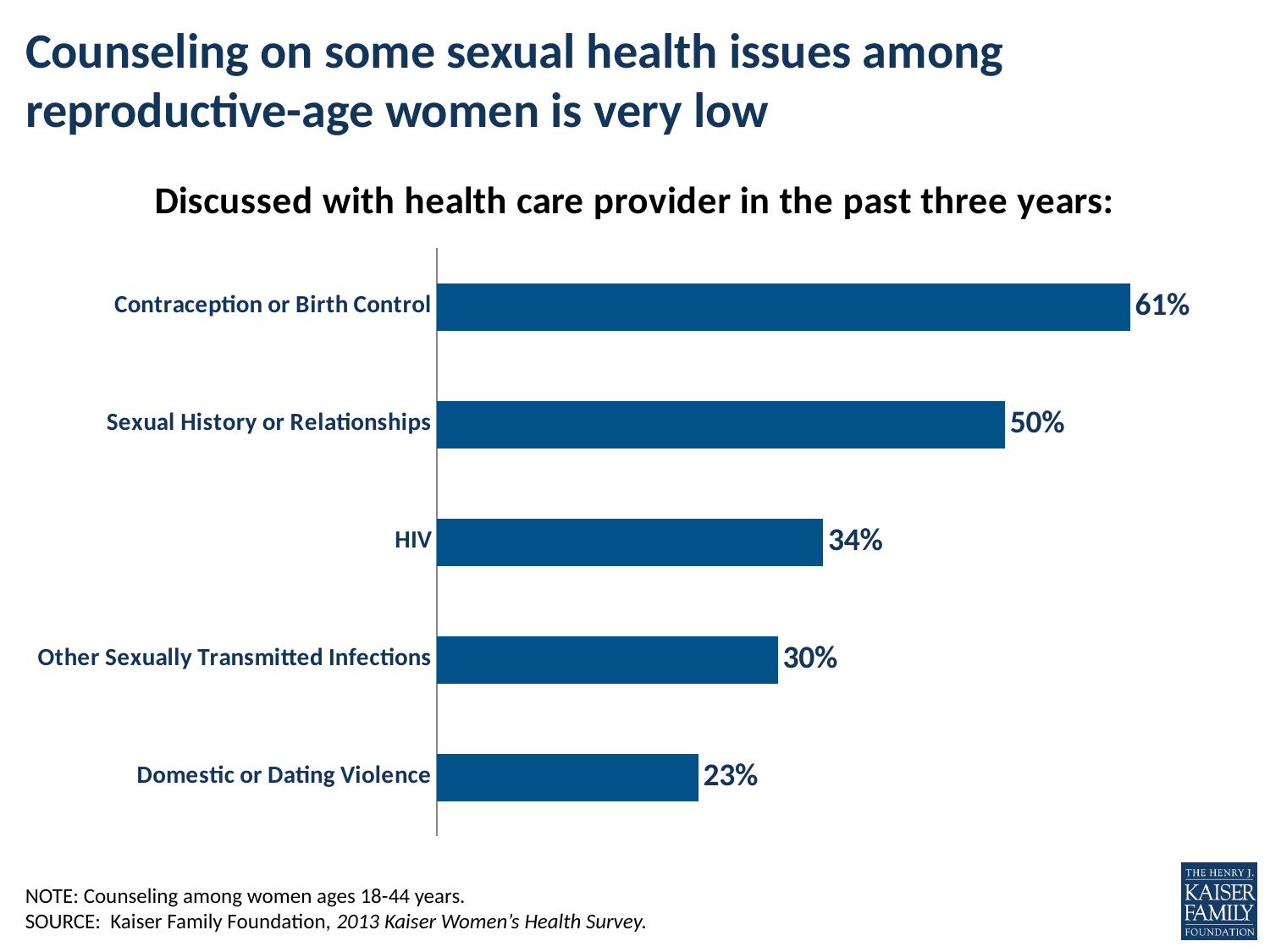
Which is larger, the value for Sexual History or Relationships or the value for HIV? Sexual History or Relationships What is the subtitle shown above the chart? Discussed with health care provider in the past three years: What percentage of women discussed Contraception or Birth Control with a health care provider in the past three years? 61% What kind of chart is shown on the slide? Bar chart What is the difference in percentage points between HIV and Other Sexually Transmitted Infections? 4 Which topic has the highest percentage of women who discussed it with a health care provider? Contraception or Birth Control What is the value shown for Other Sexually Transmitted Infections? 30% What is the difference in percentage points between Contraception or Birth Control and Sexual History or Relationships? 11 How many topics are shown in the chart? 5 Which topic has the lowest percentage? Domestic or Dating Violence What is the value shown for HIV? 34% What is the value shown for Domestic or Dating Violence? 23%